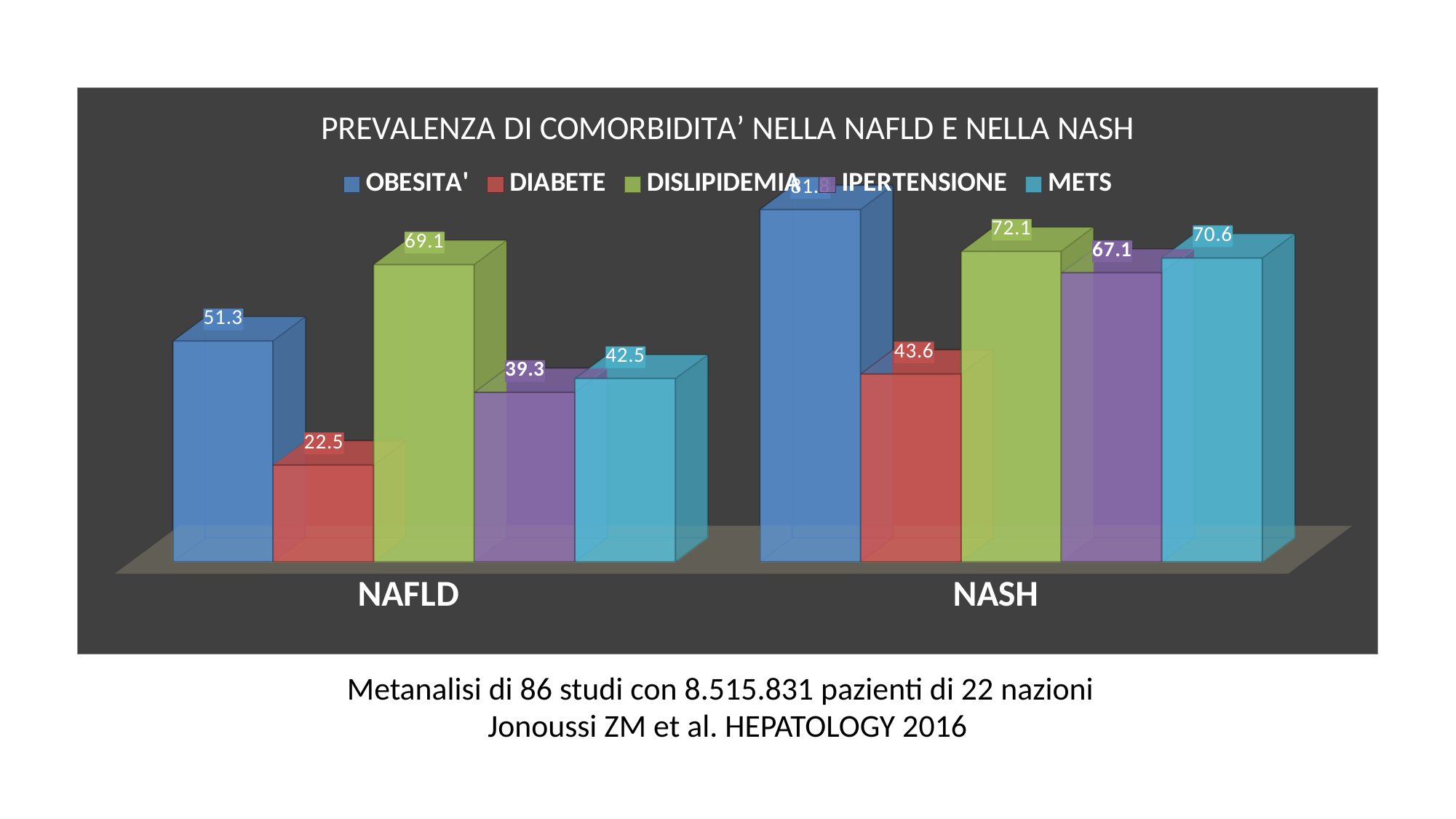
What is the difference between the DISLIPIDEMIA values for NASH and NAFLD? 3.0 How many series does the legend list? 5 Which is larger, the IPERTENSIONE value for NAFLD or the METS value for NAFLD? METS What is the value for IPERTENSIONE in the NASH group? 67.1 What is the value for DISLIPIDEMIA in the NASH group? 72.1 Which series has the highest value in the NAFLD group? DISLIPIDEMIA What is the difference between the DIABETE values for NASH and NAFLD? 21.1 Which series has the highest value in the NASH group? OBESITA' What is the value for METS in the NAFLD group? 42.5 What kind of chart is shown on the slide? Bar chart What is the value for DIABETE in the NAFLD group? 22.5 Which series has the lowest value in the NAFLD group? DIABETE